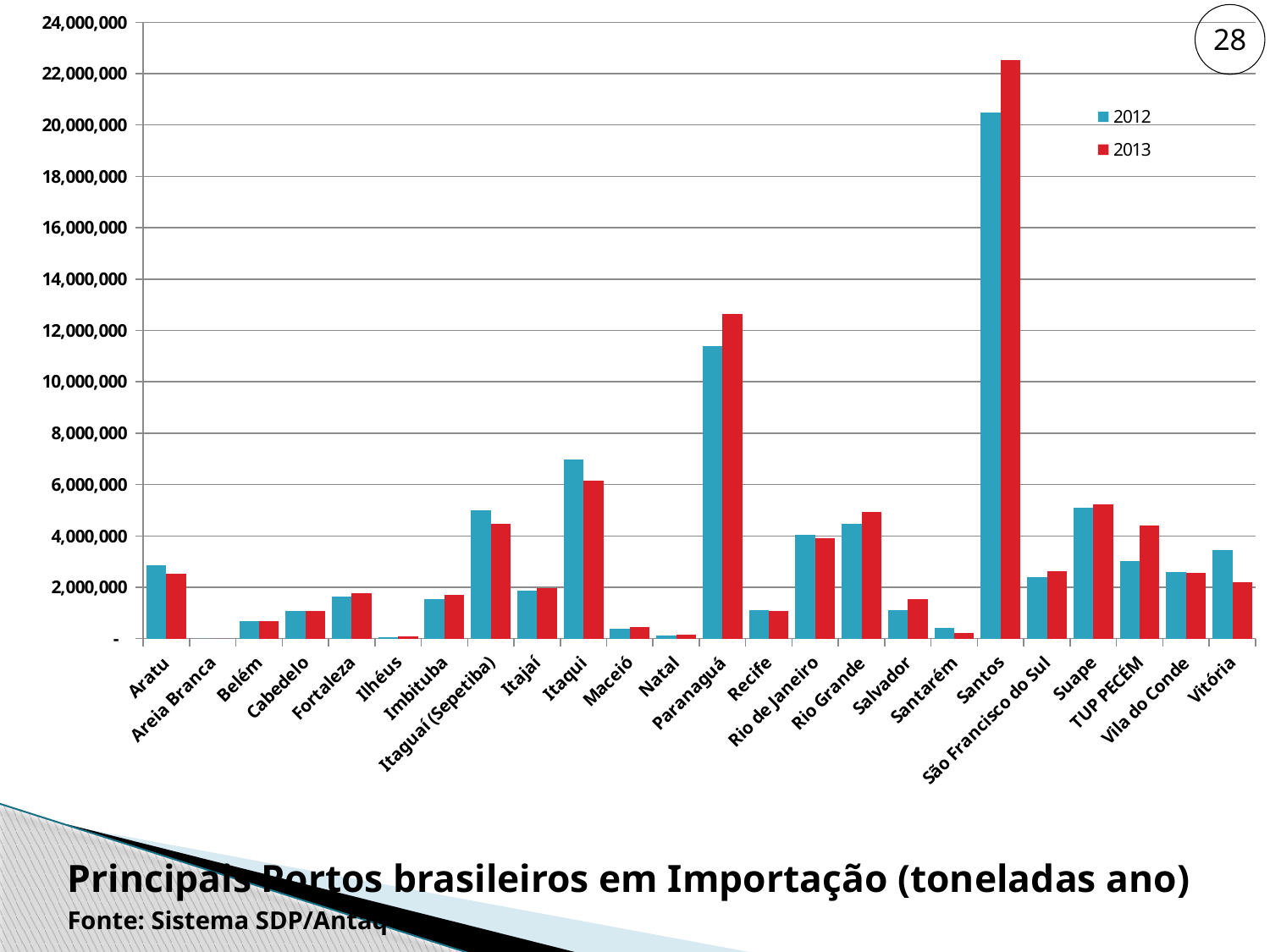
Which port has the highest import value in 2012? Santos For Santos, which year has the larger value, 2012 or 2013? 2013 Which port has the highest import value in 2013? Santos Is the 2012 value for TUP PECÉM greater or less than 2,000,000? greater How many series does the legend list? 2 What is the title of the chart? Principais Portos brasileiros em Importação (toneladas ano) What kind of chart is shown on the slide? bar chart Is the 2013 value for Paranaguá greater or less than 12,000,000? greater Is the 2012 value for Santos greater or less than 20,000,000? greater For Itaqui, which year has the larger value, 2012 or 2013? 2012 Which port has the lowest import value in 2012? Areia Branca How many ports are shown on the x axis? 24